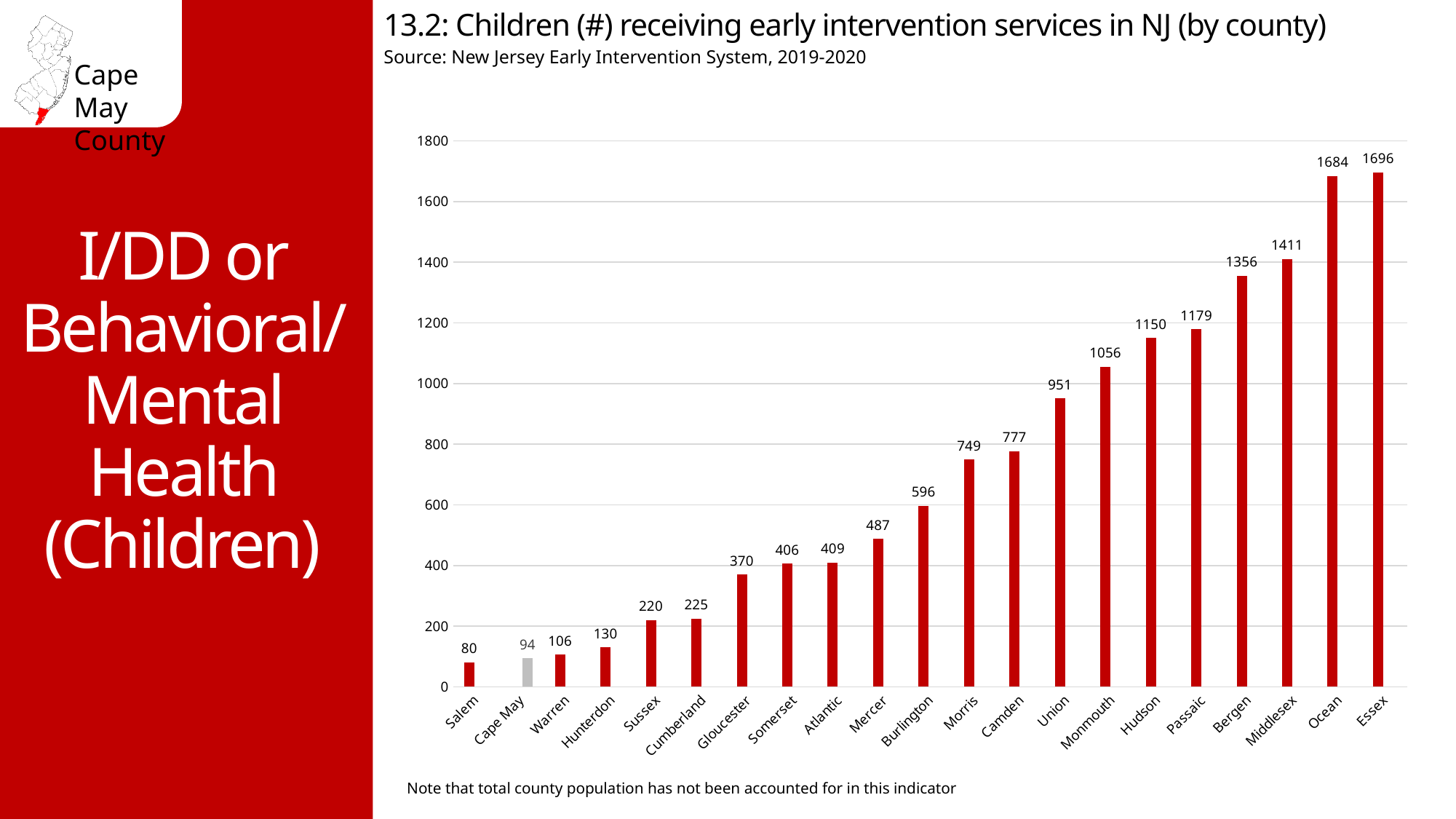
Which has a larger value, Union or Camden? Union Is the value for Bergen greater or less than 1200? greater How many children received early intervention services in Cape May County? 94 What kind of chart is shown on the slide? Bar chart Which county has the highest number of children receiving early intervention services? Essex What is the value shown for Gloucester? 370 What is the difference between the values for Ocean and Middlesex? 273 What is the value shown for Monmouth? 1056 Which county's bar is shown in grey rather than red? Cape May How many counties are shown on the chart? 21 What is the difference between the values for Cape May and Salem? 14 Which county has the lowest number of children receiving early intervention services? Salem